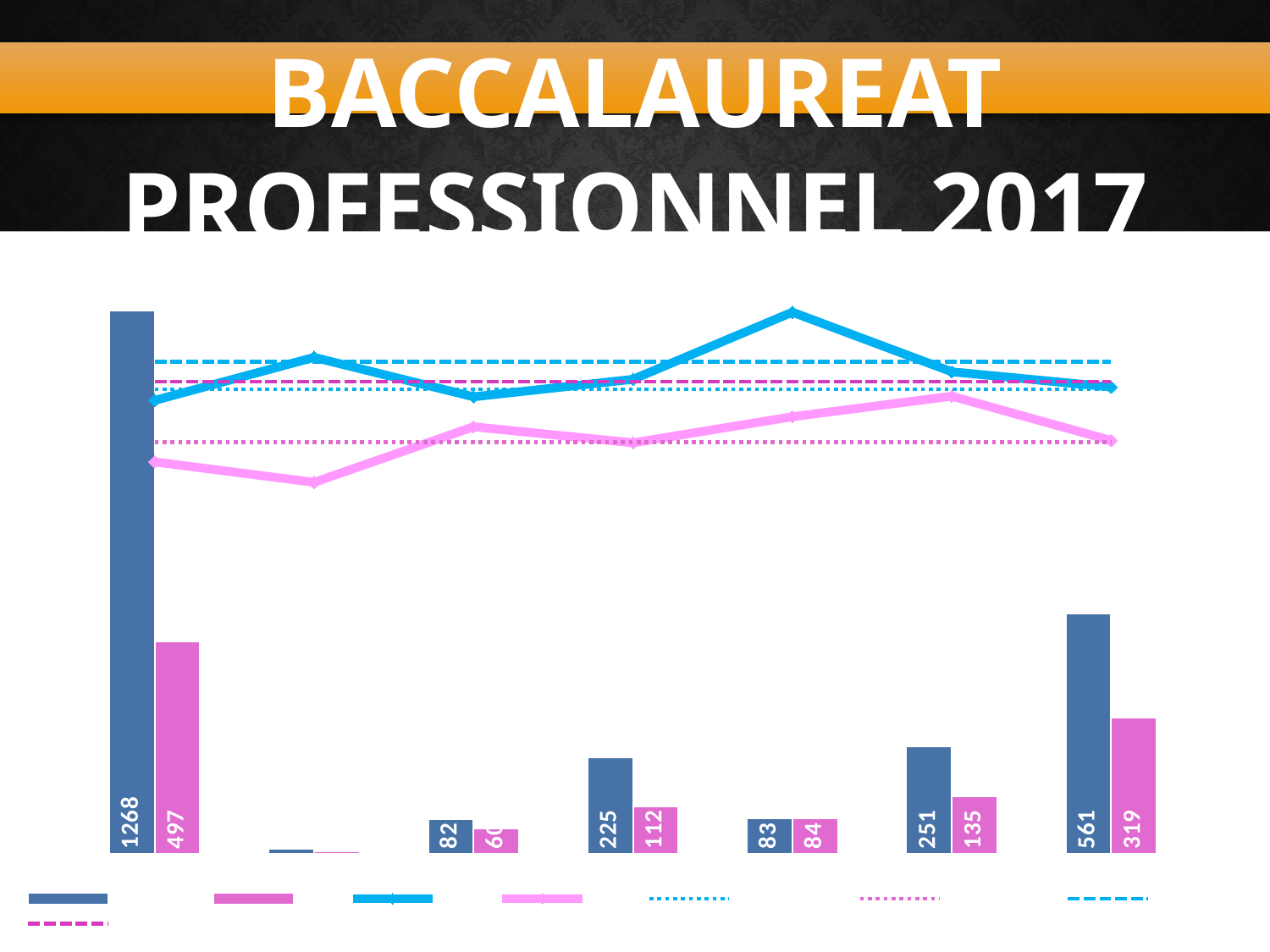
How many groups of bars are plotted along the x axis? 7 How many entries does the legend at the bottom of the chart show? 8 What is the value of the pink bar in the leftmost group? 497 What is the value of the tallest blue bar, in the leftmost group? 1268 What is the value of the pink bar in the fourth group from the left? 112 In the fifth group from the left, which bar is larger, the blue bar (83) or the pink bar (84)? The pink bar (84) Which group of bars has the highest blue bar? The leftmost group (1268) What is the difference between the blue bar and the pink bar in the leftmost group? 771 What is the value of the blue bar in the rightmost group? 561 What is the title of the slide? BACCALAUREAT PROFESSIONNEL 2017 What is the difference between the blue bar (561) and the pink bar (319) in the rightmost group? 242 What kind of chart is shown on the slide? A combined bar and line chart